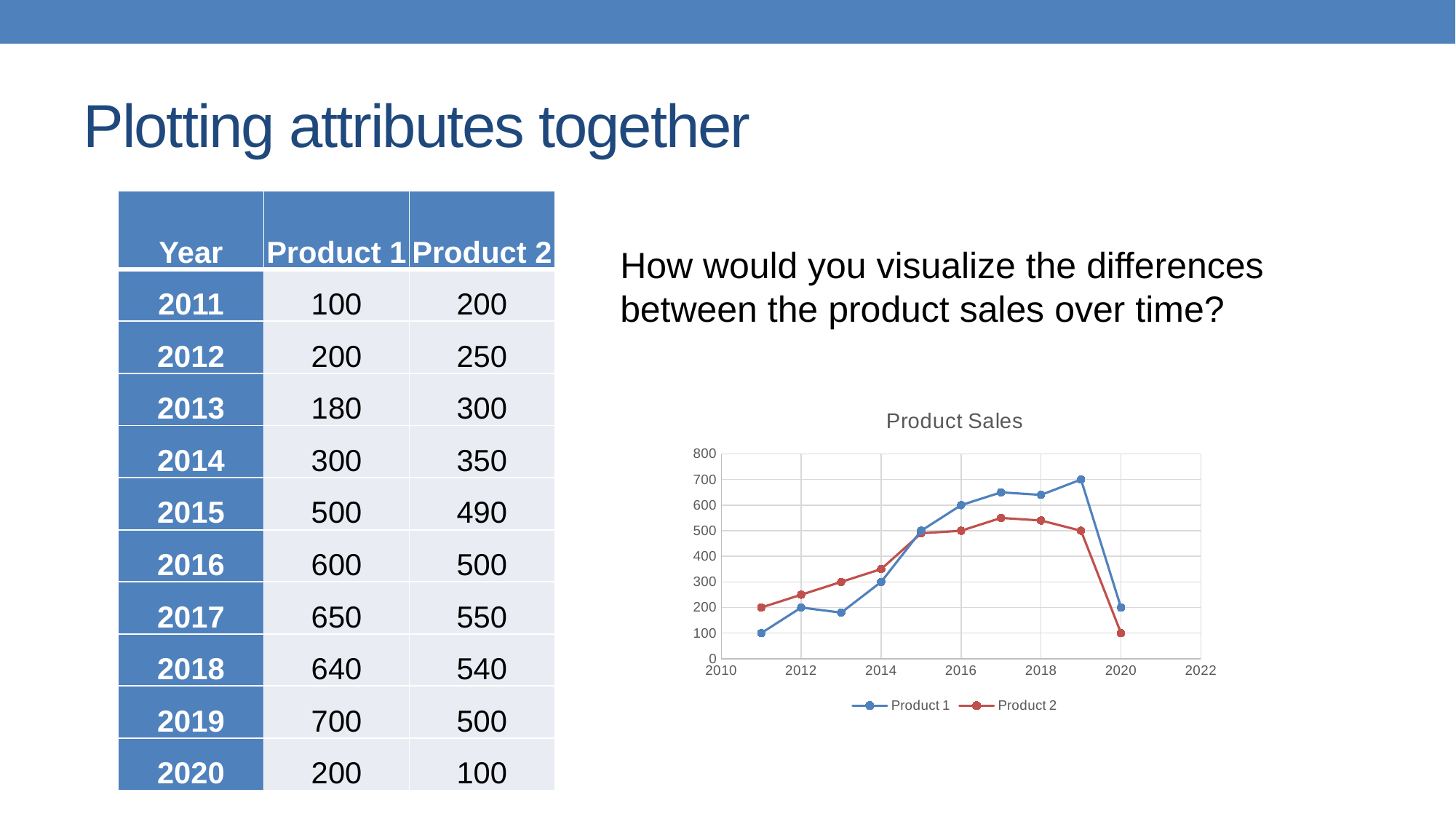
In the Product Sales chart, which is larger in 2013, Product 1 or Product 2? Product 2 What is the title of the chart on the slide? Product Sales In the Product Sales chart, does Product 2 rise or fall from 2011 to 2017? rise How many series does the legend of the Product Sales chart list? 2 In the Product Sales chart, which year has the highest value for Product 1? 2019 In the Product Sales chart, what is the value for Product 1 in 2019? 700 What kind of chart is the Product Sales chart? line chart In the Product Sales chart, what is the difference between Product 1 and Product 2 in 2019? 200 How many years are plotted for each series in the Product Sales chart? 10 In the Product Sales chart, which year has the lowest value for Product 2? 2020 In the Product Sales chart, what is the value for Product 2 in 2017? 550 In the Product Sales chart, is the value for Product 1 in 2017 greater or less than 600? greater